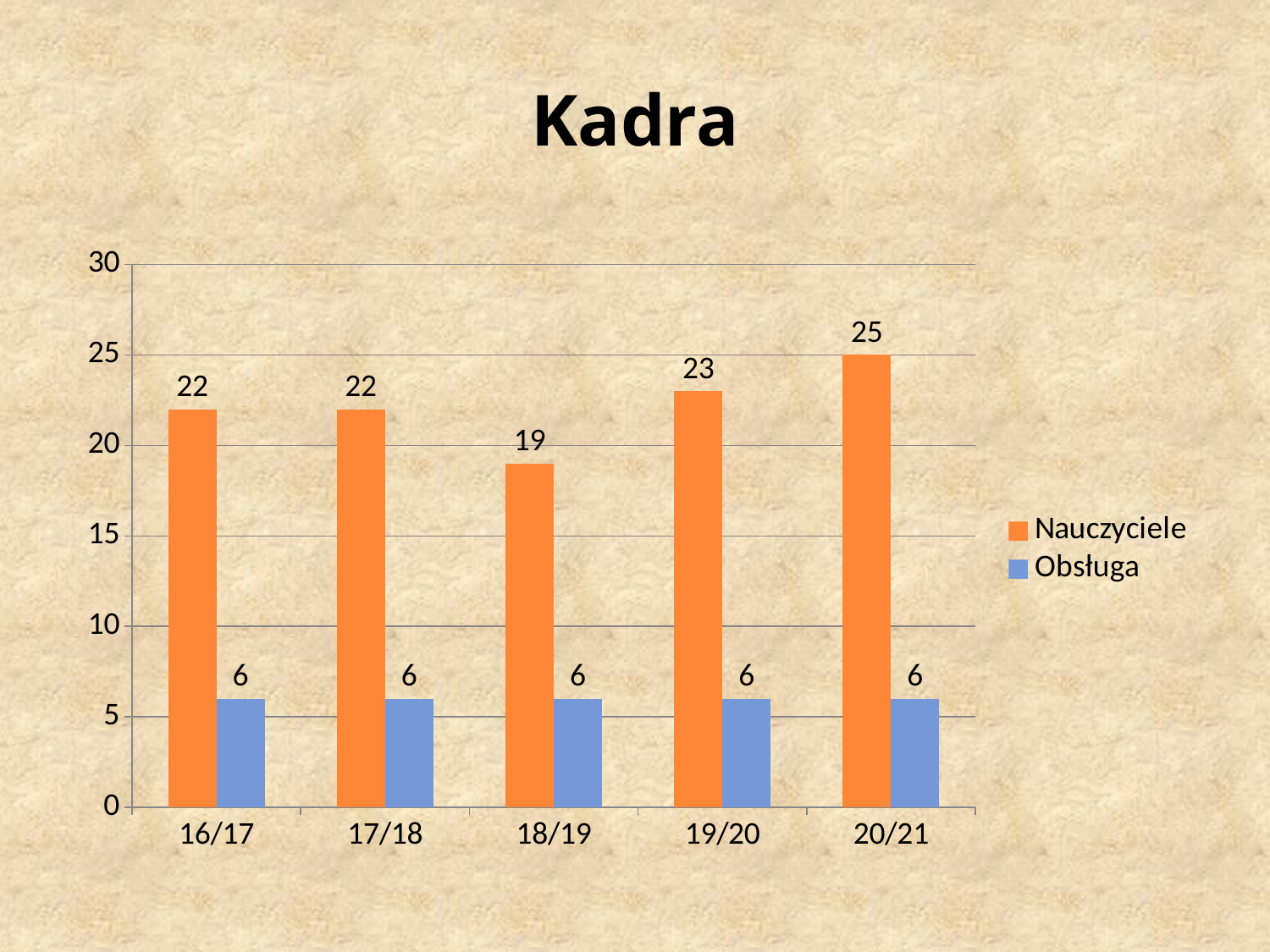
What is the title of the chart? Kadra Is the value for Nauczyciele in 19/20 greater or less than 20? greater What is the value for Obsługa in 20/21? 6 What is the value for Nauczyciele in 18/19? 19 What is the value for Nauczyciele in 20/21? 25 In which year is the Nauczyciele value lowest? 18/19 In which year is the Nauczyciele value highest? 20/21 What is the difference between the Nauczyciele values for 20/21 and 18/19? 6 How many series does the legend list? 2 Which is larger: Nauczyciele in 19/20 or Nauczyciele in 17/18? Nauczyciele in 19/20 What kind of chart is shown on the slide? bar chart How many years are shown on the x axis? 5